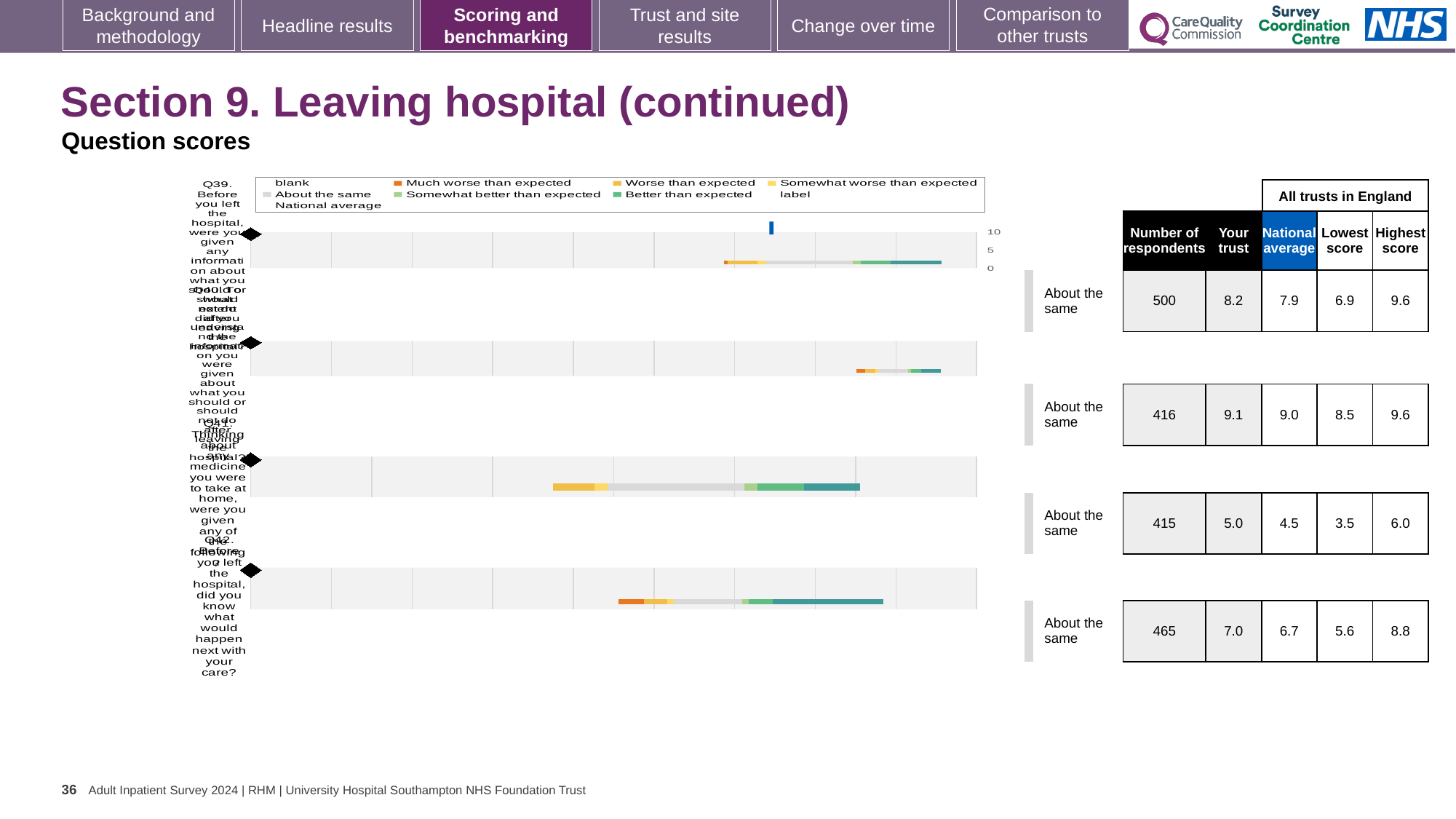
In the table, what is the national average for the third row (Q41)? 4.5 In the table, what is the number of respondents for the top row (Q39)? 500 What colour does the legend use for 'Much worse than expected'? orange What is the highest score among all trusts in England for the third row (Q41)? 6.0 In the table, what is 'Your trust' score for the bottom row (Q42)? 7.0 What is the difference between 'Your trust' and the national average for the top row (Q39)? 0.3 Is the 'Your trust' score for the bottom row (Q42) larger or smaller than its national average? larger Which row in the table has the lowest 'Your trust' score? third row (Q41), 5.0 How many question rows are plotted in the chart? 4 Which row in the table has the highest 'Your trust' score? second row (Q40), 9.1 What benchmark label is shown beside each of the four rows? About the same What kind of chart is shown on the left of the slide? bar chart